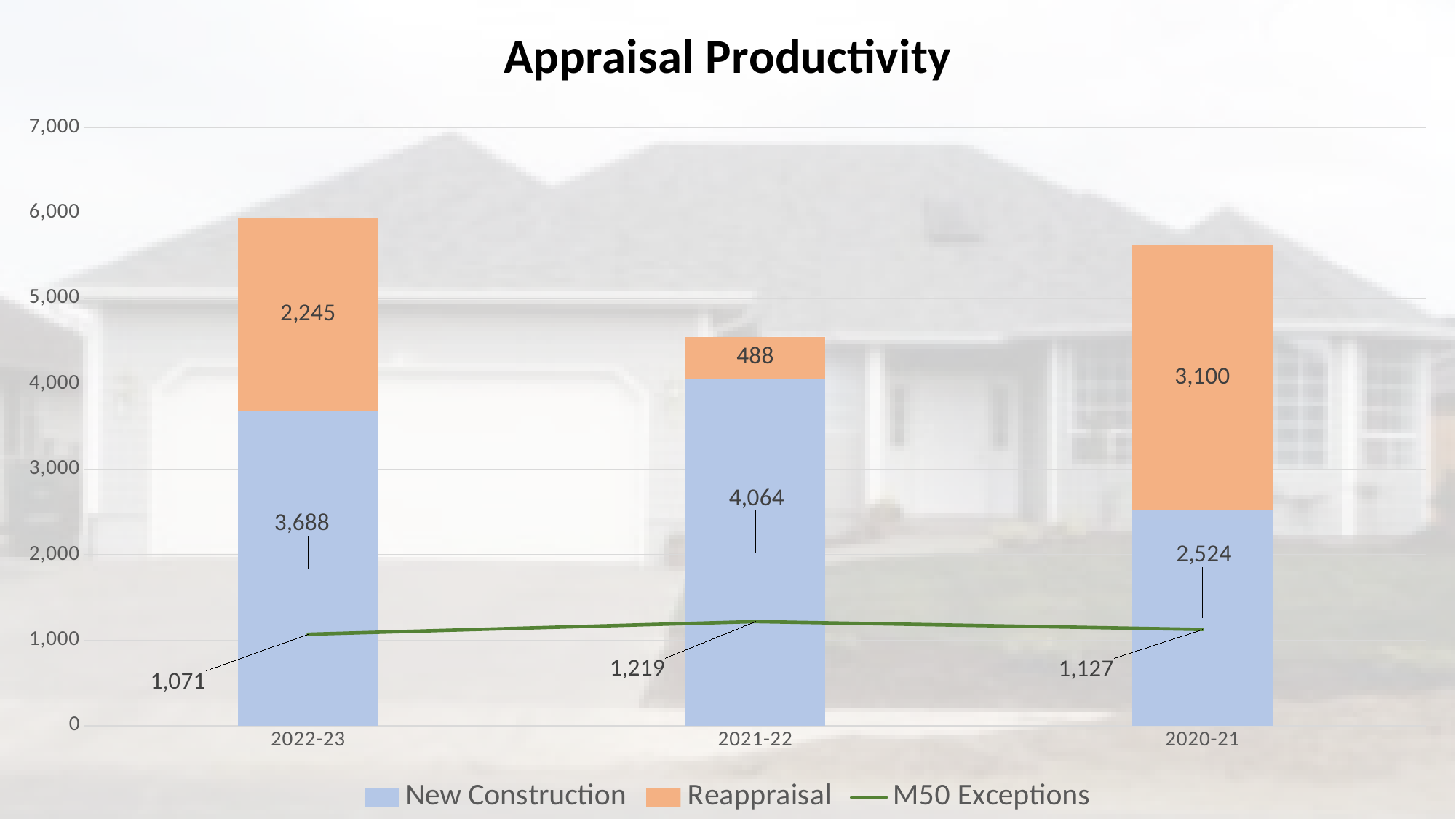
What is the total of the stacked bar for 2021-22? 4,552 How many years are shown on the x axis? 3 What is the total of the stacked bar for 2022-23? 5,933 How many series does the legend list? 3 What is the New Construction value for 2021-22? 4,064 What is the difference between the Reappraisal values for 2022-23 and 2021-22? 1,757 Which year has the highest Reappraisal value? 2020-21 Which is larger: the M50 Exceptions value for 2021-22 or for 2020-21? 2021-22 What is the title of the chart? Appraisal Productivity What is the Reappraisal value for 2020-21? 3,100 What is the M50 Exceptions value for 2022-23? 1,071 Which year has the lowest New Construction value? 2020-21